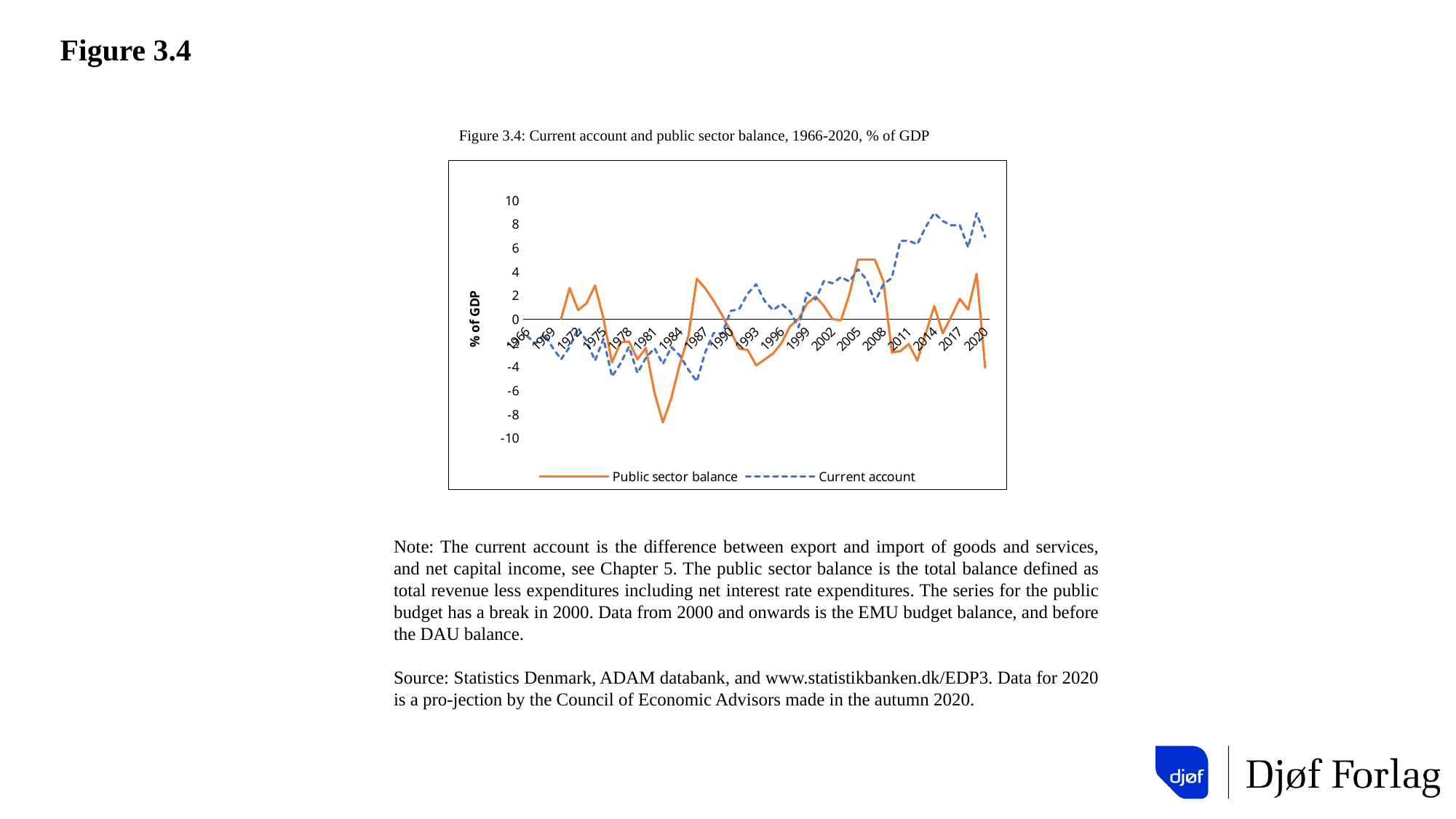
Is the value of the Current account in 2014 greater or less than 6? greater How many series does the legend list? 2 What is the label on the vertical axis? % of GDP Is the lowest value of the Public sector balance, around 1982, greater or less than -6? less Which series is drawn with a dashed line? Current account Which series reaches the highest value anywhere on the chart? Current account Which series reaches the lowest value anywhere on the chart? Public sector balance In 2020, which series has the higher value, Public sector balance or Current account? Current account Does the Current account series generally rise or fall from 1966 to 2020? Rise What is the title of the chart? Figure 3.4: Current account and public sector balance, 1966-2020, % of GDP What kind of chart is shown in Figure 3.4? Line chart Is the value of the Public sector balance in 2020 greater or less than -2? less